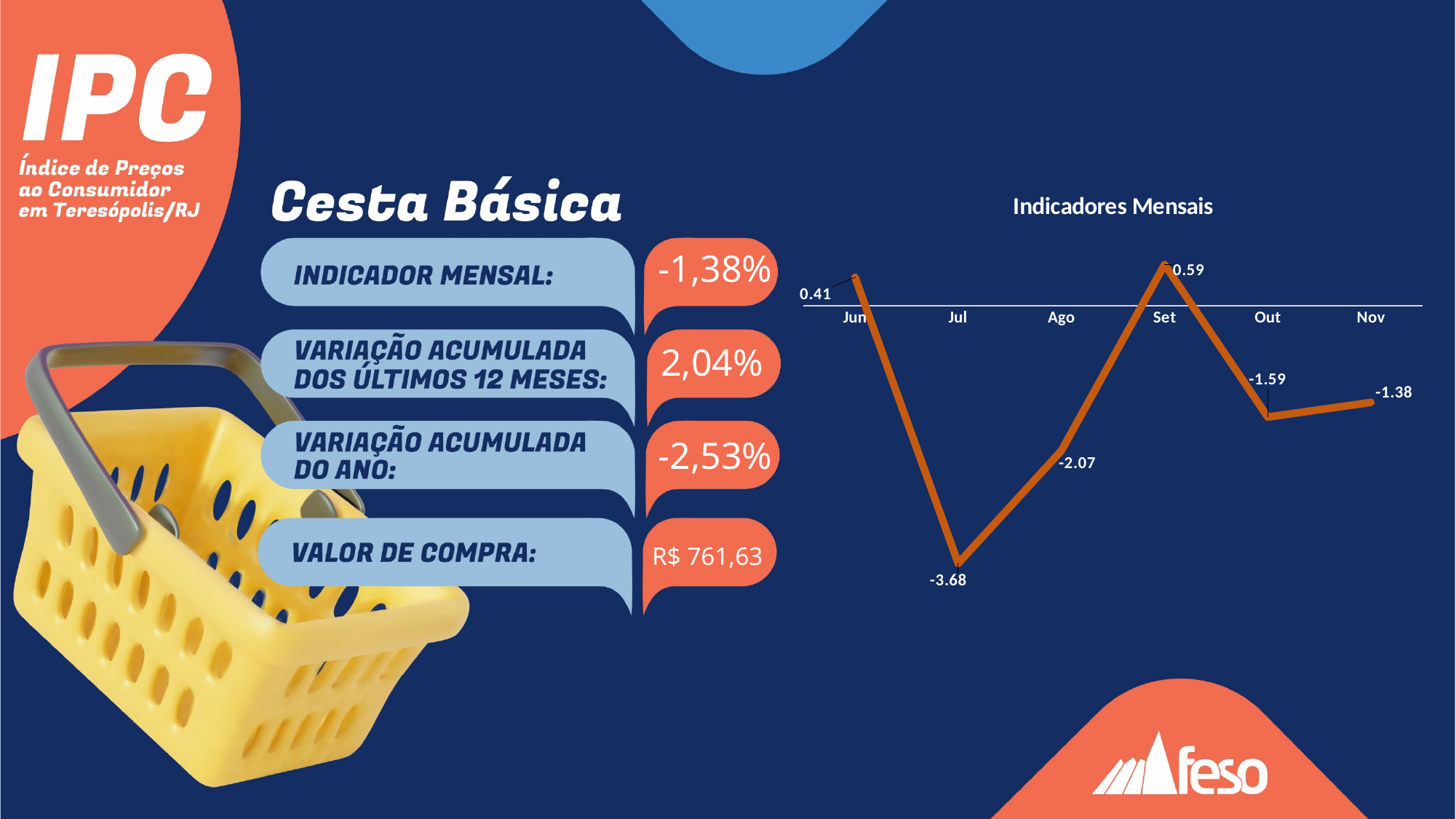
Which month has the lowest value on the "Indicadores Mensais" chart? Jul What is the title of the chart on the slide? Indicadores Mensais What is the value for Jul on the "Indicadores Mensais" chart? -3.68 How many months are plotted on the "Indicadores Mensais" chart? 6 What is the value for Nov on the "Indicadores Mensais" chart? -1.38 On the "Indicadores Mensais" chart, what is the difference between the values for Out and Nov? 0.21 On the "Indicadores Mensais" chart, does the value rise or fall from Jun to Jul? fall What type of chart is shown under the title "Indicadores Mensais"? line chart On the "Indicadores Mensais" chart, what is the difference between the values for Set and Jul? 4.27 Which month has the highest value on the "Indicadores Mensais" chart? Set On the "Indicadores Mensais" chart, which is larger, the value for Ago or the value for Out? Out What is the value for Set on the "Indicadores Mensais" chart? 0.59